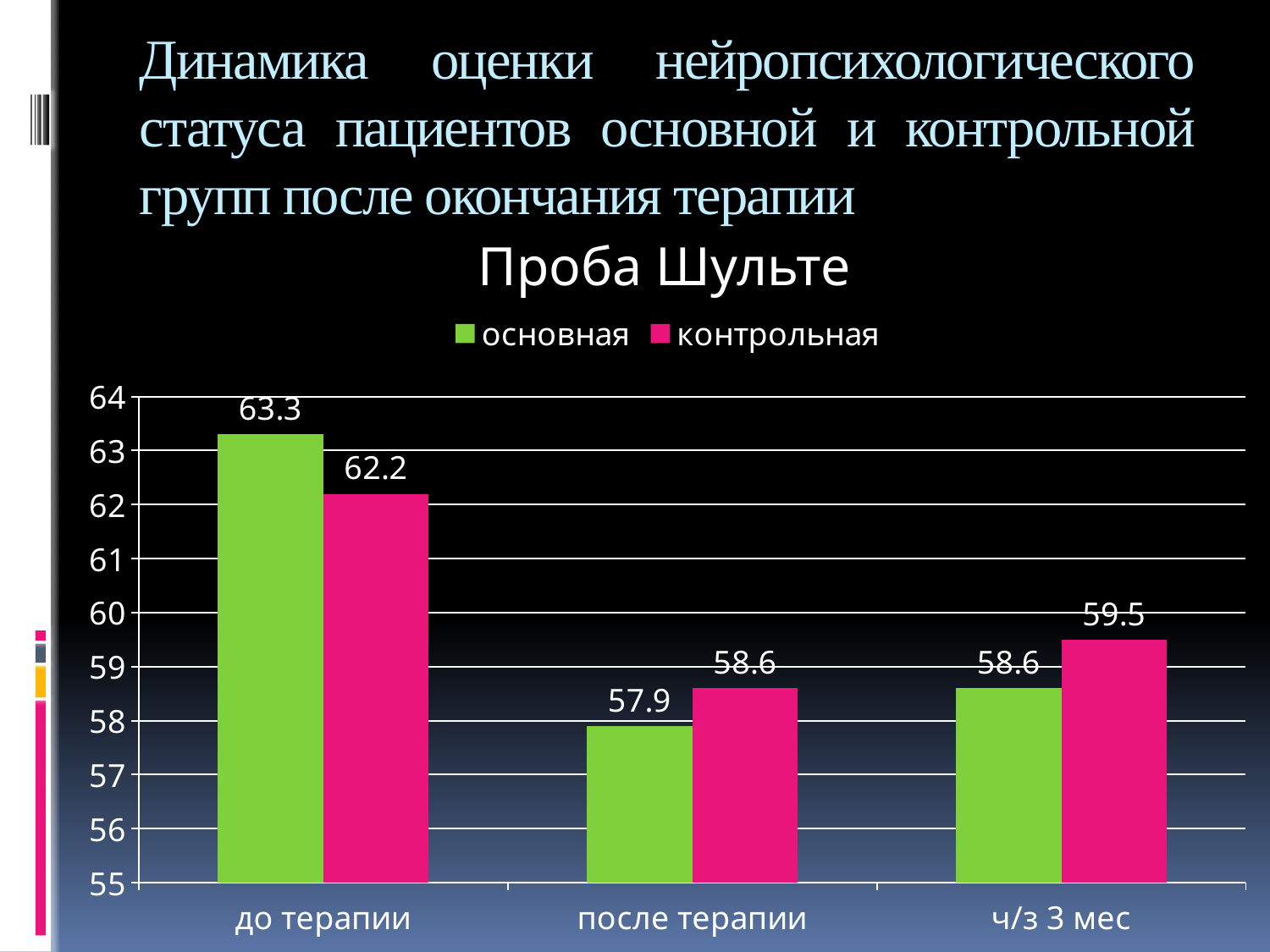
At which category is the основная series highest? до терапии What kind of chart is shown? bar chart What is the difference between основная and контрольная at до терапии? 1.1 At which category is the основная series lowest? после терапии What is the value for контрольная at ч/з 3 мес? 59.5 Which is larger at ч/з 3 мес: основная or контрольная? контрольная How many categories are shown on the x axis? 3 What is the value for основная at до терапии? 63.3 What is the value for контрольная at после терапии? 58.6 How many series does the legend list? 2 Is the value for контрольная at до терапии greater or less than 60? greater What is the title of the chart? Проба Шульте